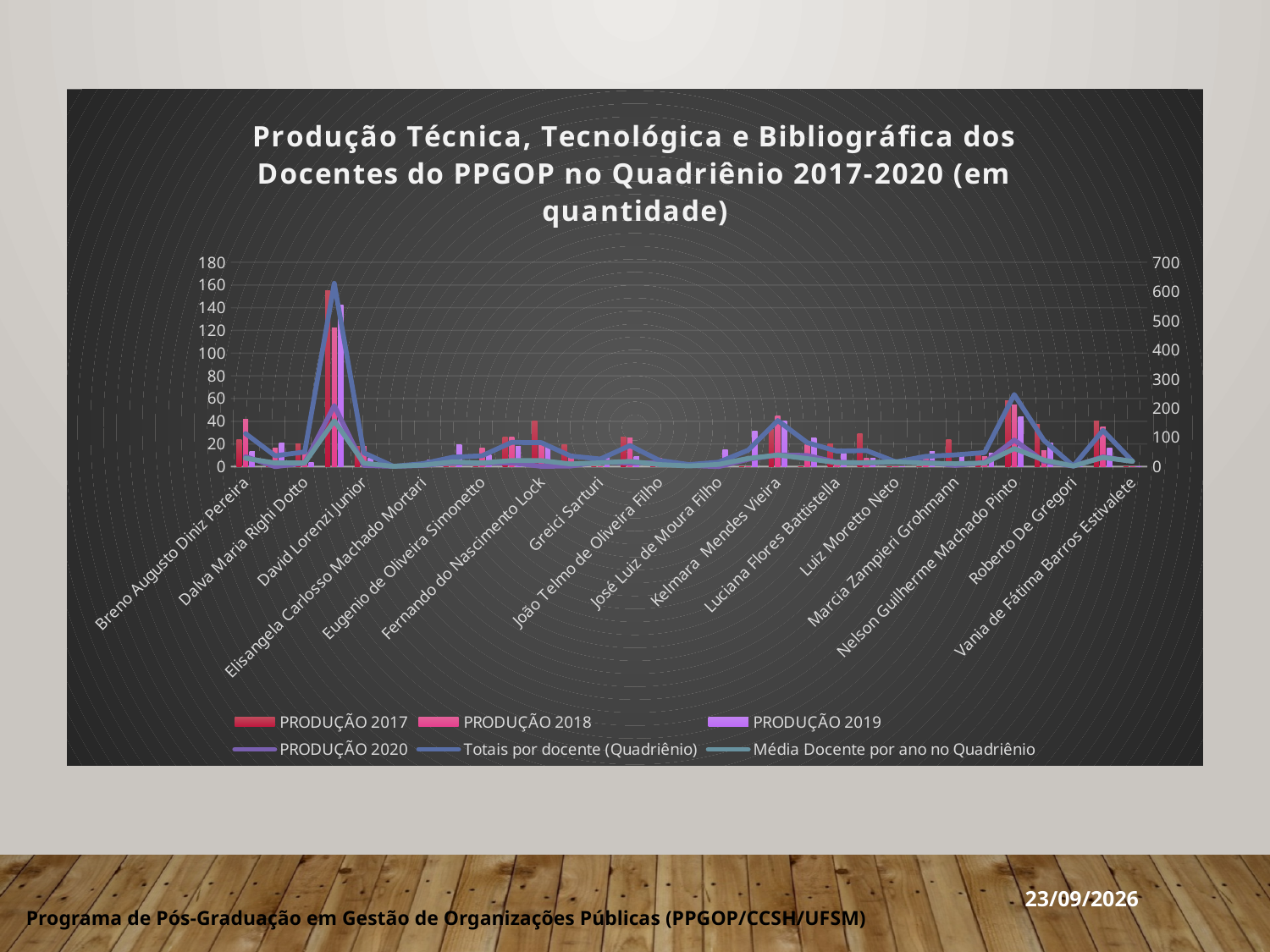
How many series does the legend list? 6 What is the maximum value shown on the left vertical axis? 180 Which is larger, the 'Totais por docente (Quadriênio)' value for Nelson Guilherme Machado Pinto or for Elisangela Carlosso Machado Mortari? Nelson Guilherme Machado Pinto What kind of chart is shown on the slide? A combined bar and line chart Which is larger, the PRODUÇÃO 2017 value for David Lorenzi Junior or for Luiz Moretto Neto? David Lorenzi Junior What is the maximum value shown on the right vertical axis? 700 Is the PRODUÇÃO 2017 value for David Lorenzi Junior greater or less than 140? less Is the 'Totais por docente (Quadriênio)' value for David Lorenzi Junior greater or less than 500 on the right axis? less Is the PRODUÇÃO 2017 value for Greici Sarturi greater or less than 40? less